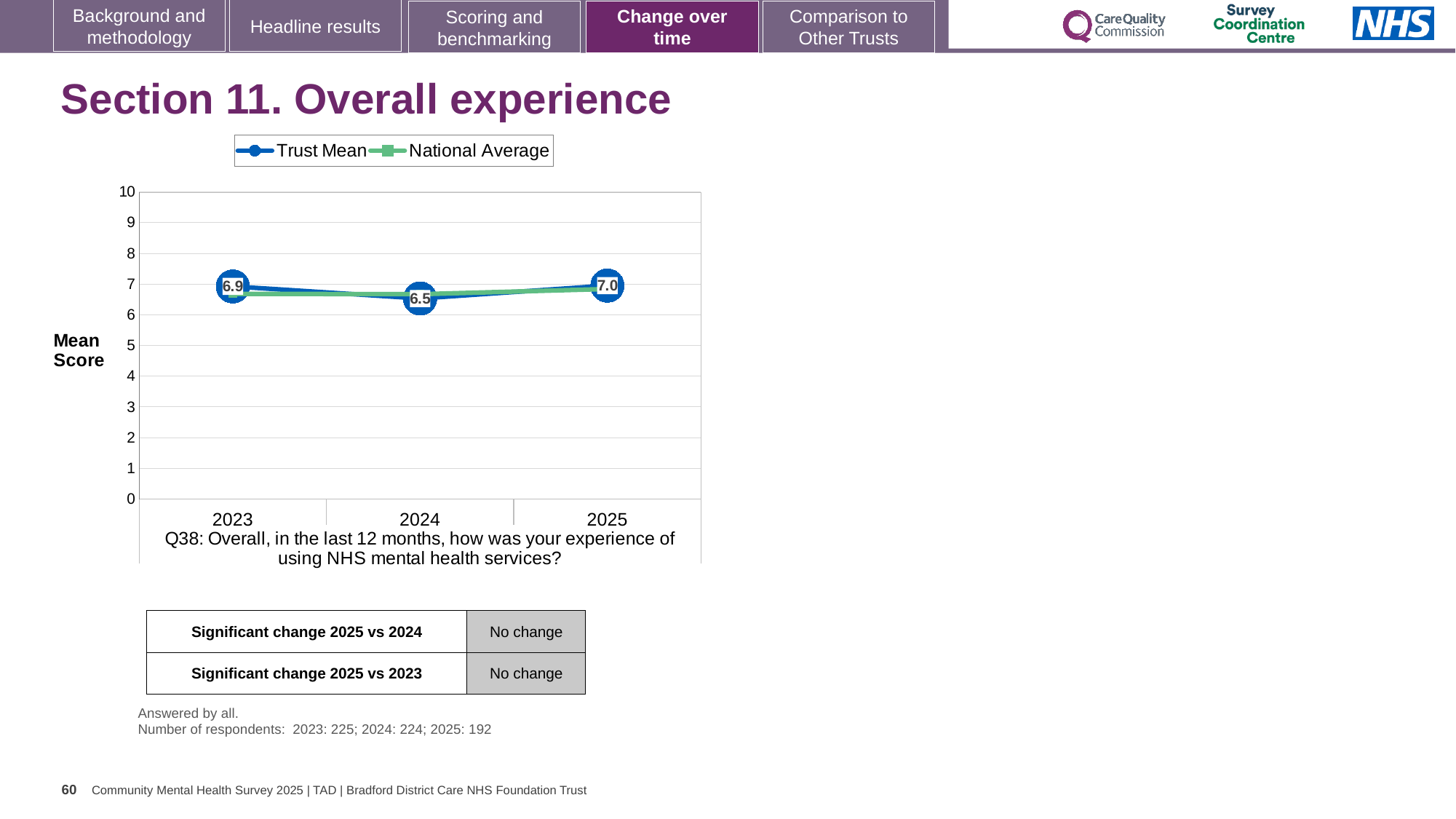
In which year is the Trust Mean score lowest? 2024 What is the Trust Mean score for 2025? 7.0 How many years are shown on the x axis of the chart? 3 What kind of chart is shown on the slide? Line chart What is the difference between the Trust Mean scores for 2025 and 2024? 0.5 In which year is the Trust Mean score highest? 2025 Does the Trust Mean score rise or fall from 2024 to 2025? Rise How many series does the chart legend list? 2 Is the National Average value for 2023 greater or less than 5? greater Which year has the larger Trust Mean score, 2024 or 2025? 2025 What is the Trust Mean score for 2024? 6.5 What is the Trust Mean score for 2023? 6.9